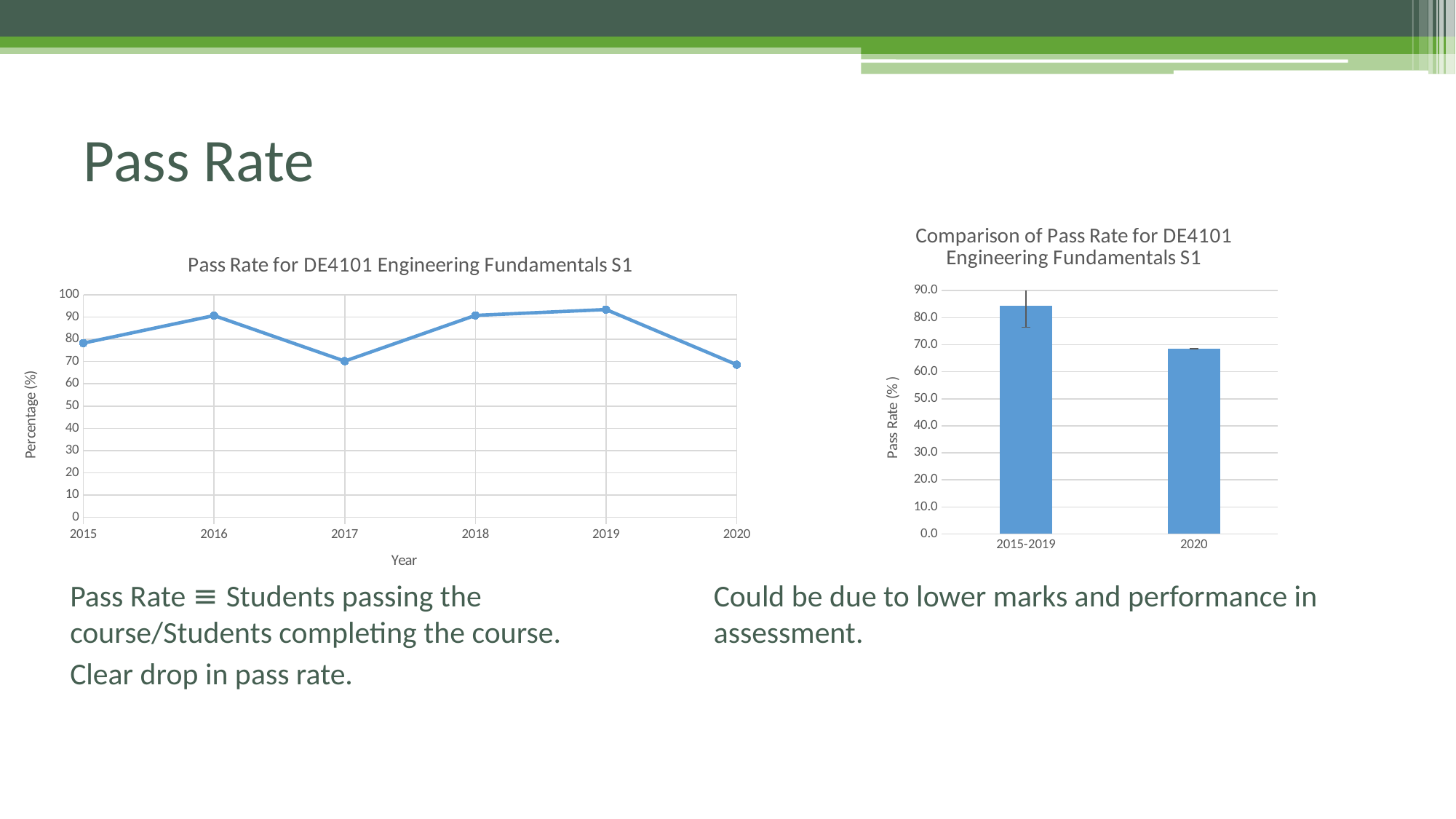
What kind of chart is the left chart, 'Pass Rate for DE4101 Engineering Fundamentals S1'? line chart In the right bar chart, how many bars are shown? 2 In the right bar chart, is the value for 2015-2019 greater or less than 80.0? greater In the left line chart, is the value for 2016 greater or less than 80? greater In the left line chart, does the pass rate rise or fall from 2019 to 2020? fall What kind of chart is the right chart, 'Comparison of Pass Rate for DE4101 Engineering Fundamentals S1'? bar chart In the left line chart, is the value for 2019 greater or less than 90? greater What is the y-axis label of the left line chart? Percentage (%) In the left line chart, how many years are plotted along the x axis? 6 In the right bar chart, which bar is taller, 2015-2019 or 2020? 2015-2019